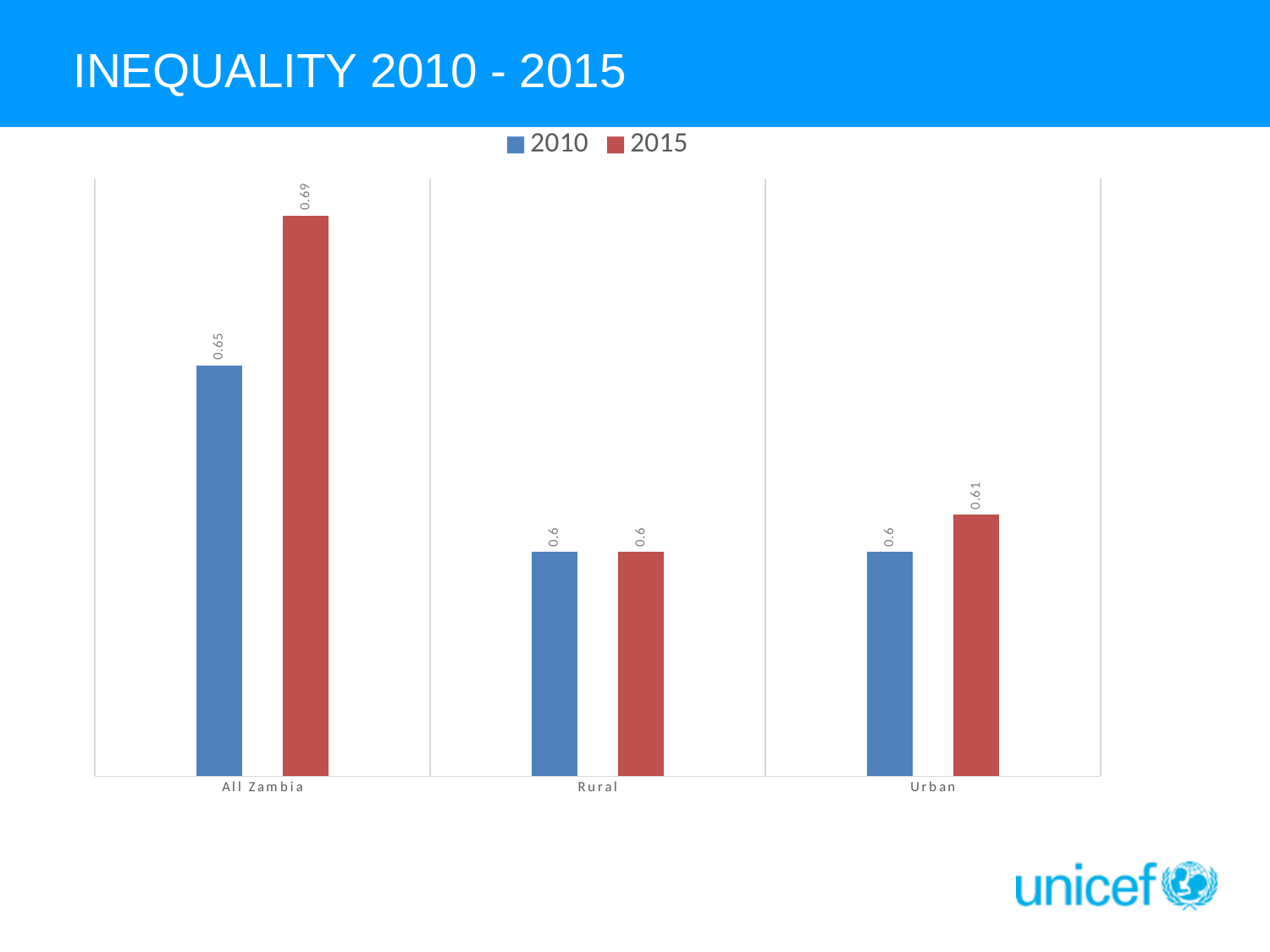
What kind of chart is shown on the slide? Bar chart What is the difference between the 2015 and 2010 values for All Zambia? 0.04 What is the 2015 value for All Zambia? 0.69 How many categories are shown on the x axis? 3 Which is larger for Urban, the 2010 value or the 2015 value? 2015 What colour represents the 2015 series? Red What is the 2015 value for Urban? 0.61 Which category has the lowest 2015 value? Rural What is the 2010 value for Rural? 0.6 Which category has the highest 2015 value? All Zambia What is the 2010 value for All Zambia? 0.65 How many series does the legend list? 2